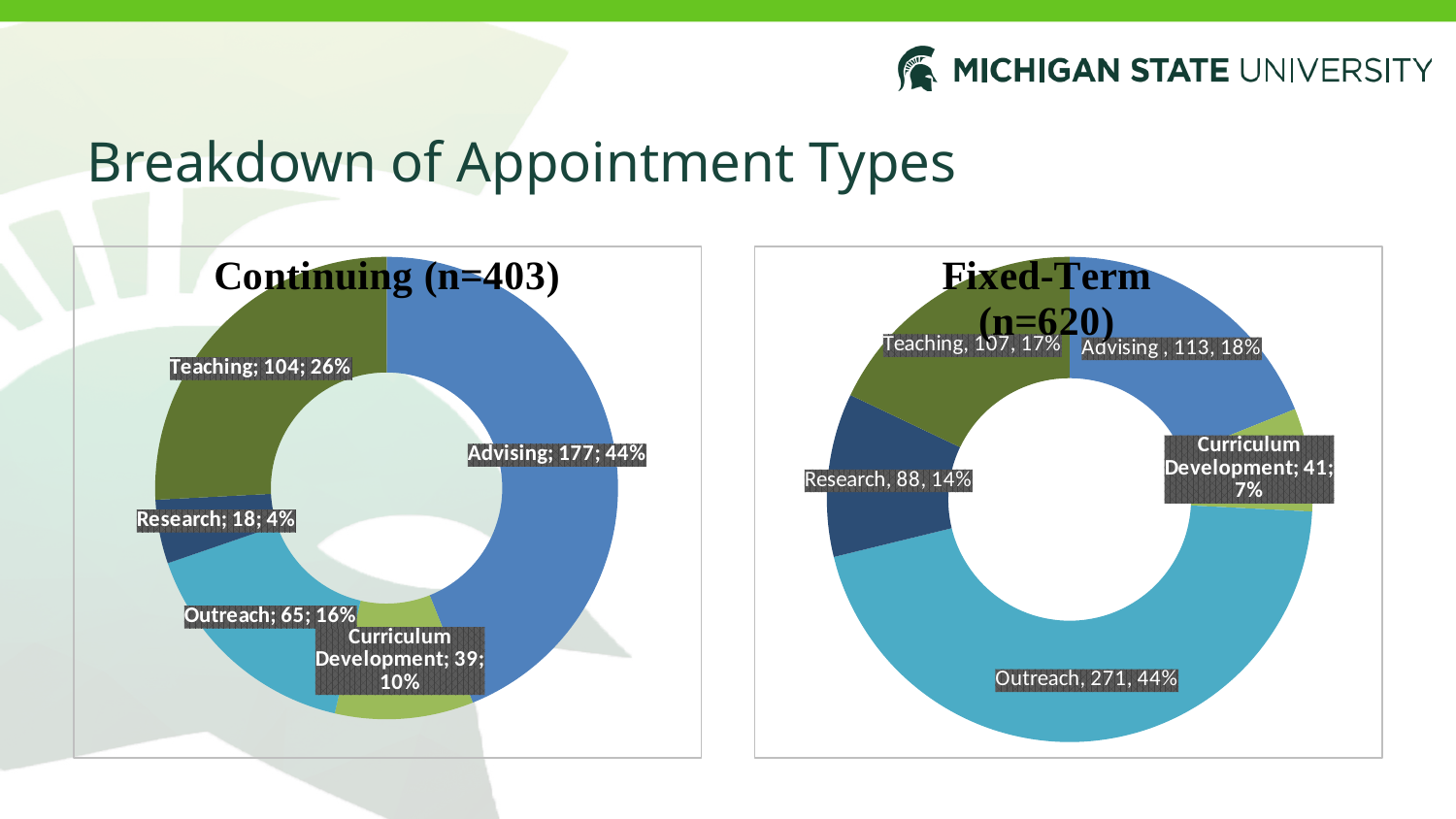
In the Fixed-Term (n=620) chart, which is larger, Advising or Teaching? Advising In the Continuing (n=403) chart, what percentage share does Teaching have? 26% In the Continuing (n=403) chart, what is the value for Advising? 177 How many categories are shown in the Fixed-Term (n=620) chart? 5 In the Fixed-Term (n=620) chart, what percentage share does Research have? 14% In the Continuing (n=403) chart, which category has the smallest value? Research In the Continuing (n=403) chart, what is the value for Curriculum Development? 39 In the Continuing (n=403) chart, what is the difference between the Advising and Teaching values? 73 In the Fixed-Term (n=620) chart, what is the value for Outreach? 271 What type of chart is the Continuing (n=403) chart? Doughnut chart What is the title of the slide? Breakdown of Appointment Types In the Fixed-Term (n=620) chart, which category has the largest value? Outreach